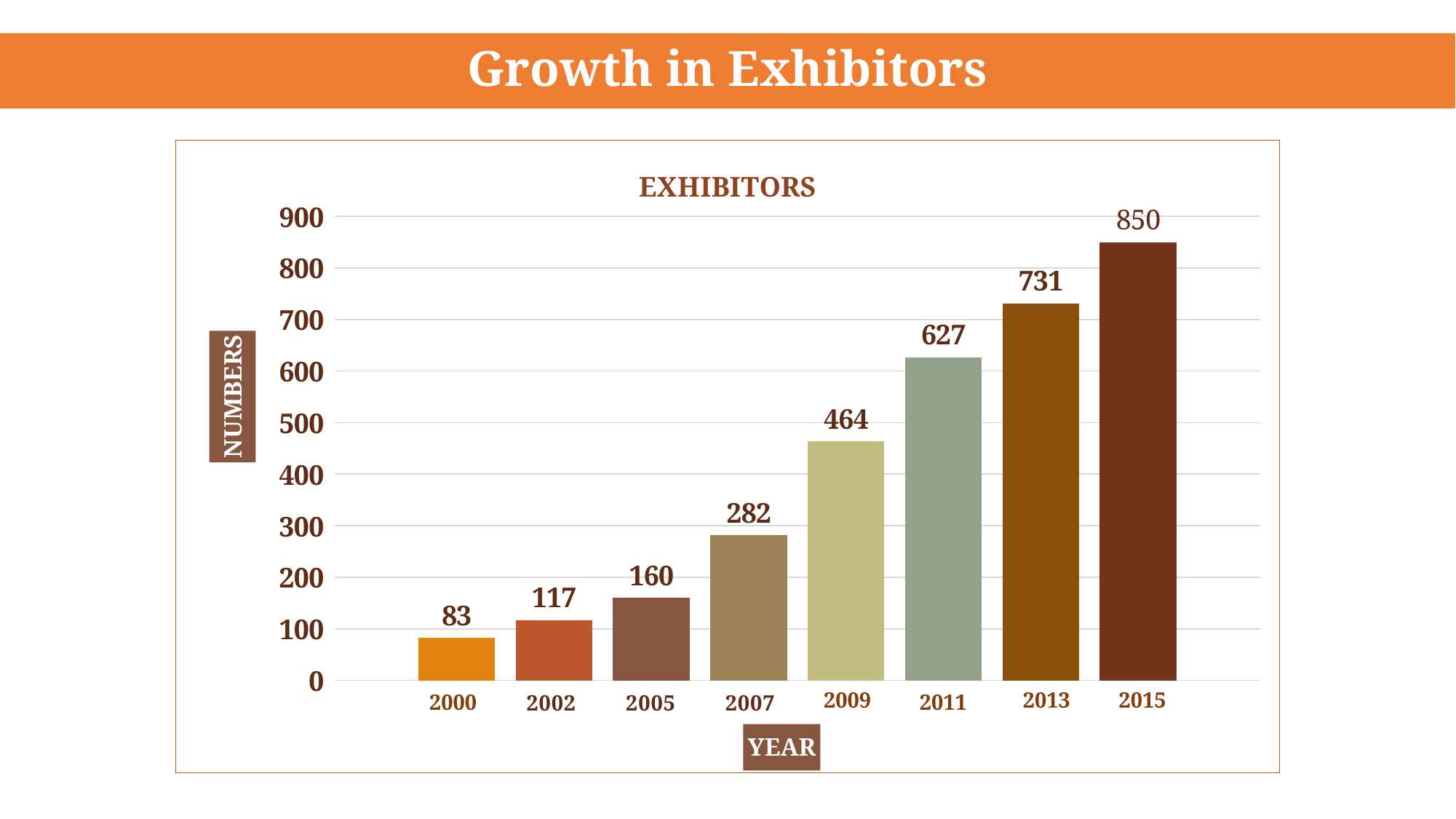
What is the number of exhibitors in 2013? 731 What kind of chart is shown on the slide? Bar chart Which year had more exhibitors, 2011 or 2009? 2011 What is the difference in exhibitors between 2007 and 2005? 122 Do the exhibitor numbers rise or fall from 2000 to 2015? Rise Is the value for 2011 greater or less than 600? greater What is the difference in exhibitors between 2015 and 2013? 119 Which year has the lowest number of exhibitors? 2000 What is the number of exhibitors in 2000? 83 How many years are shown on the x axis? 8 What is the number of exhibitors in 2009? 464 Which year has the highest number of exhibitors? 2015